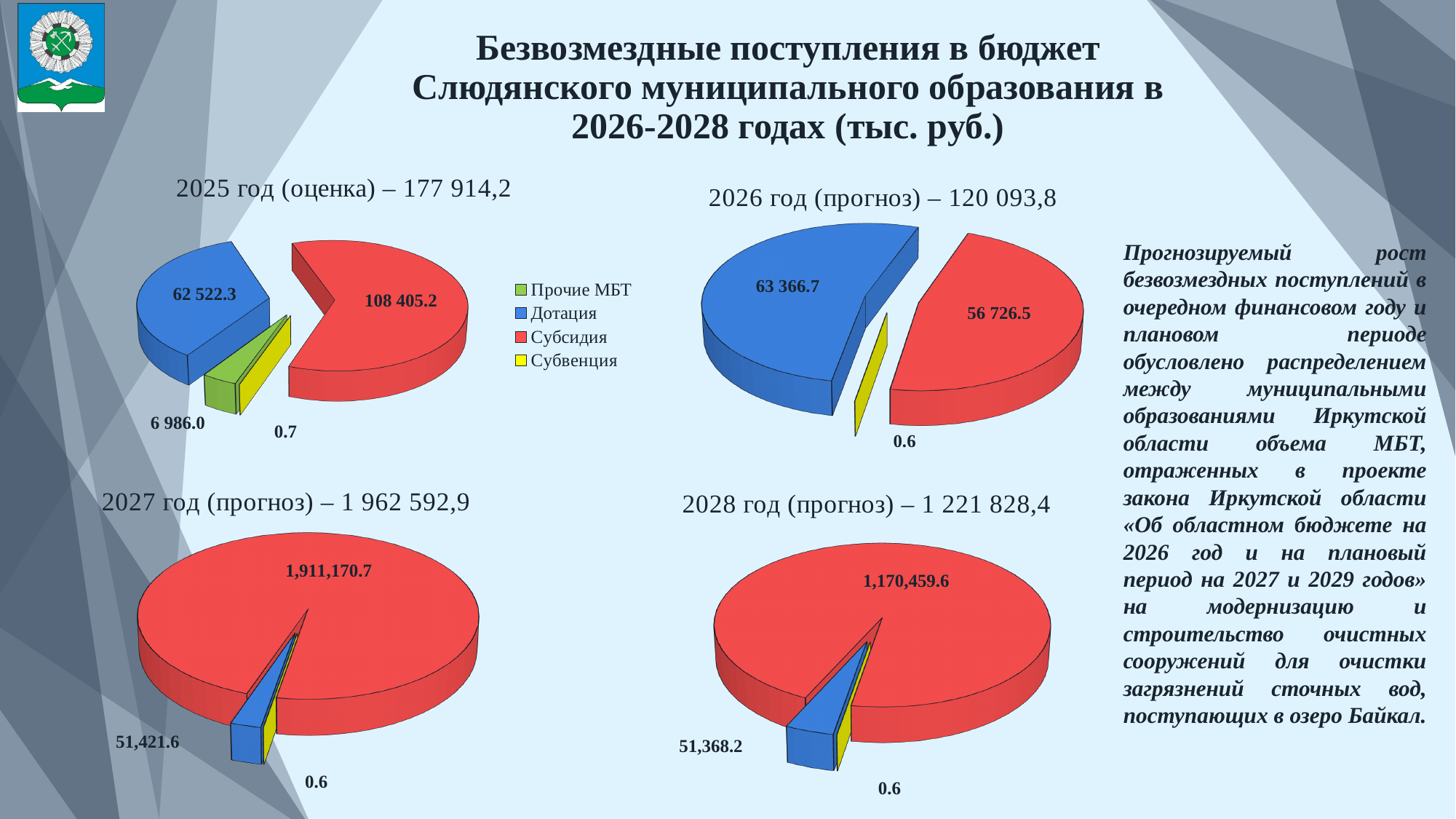
On the 2026 год (прогноз) pie chart, which category has the largest value? Дотация What kind of chart is used for the 2027 год (прогноз) data? Pie chart On the 2025 год (оценка) pie chart, what is the value for Дотация? 62 522.3 On the 2025 год (оценка) pie chart, which category has the smallest value? Субвенция On the 2025 год (оценка) pie chart, what is the value for Прочие МБТ? 6 986.0 On the 2026 год (прогноз) pie chart, which is larger, Дотация or Субсидия? Дотация How many categories does the legend list? 4 On the 2025 год (оценка) pie chart, what is the value for Субсидия? 108 405.2 On the 2026 год (прогноз) pie chart, what is the value for Дотация? 63 366.7 On the 2025 год (оценка) pie chart, what is the difference between Субсидия and Дотация? 45 882.9 On the 2028 год (прогноз) pie chart, what is the value for Дотация? 51,368.2 On the 2027 год (прогноз) pie chart, what is the value for Субсидия? 1,911,170.7